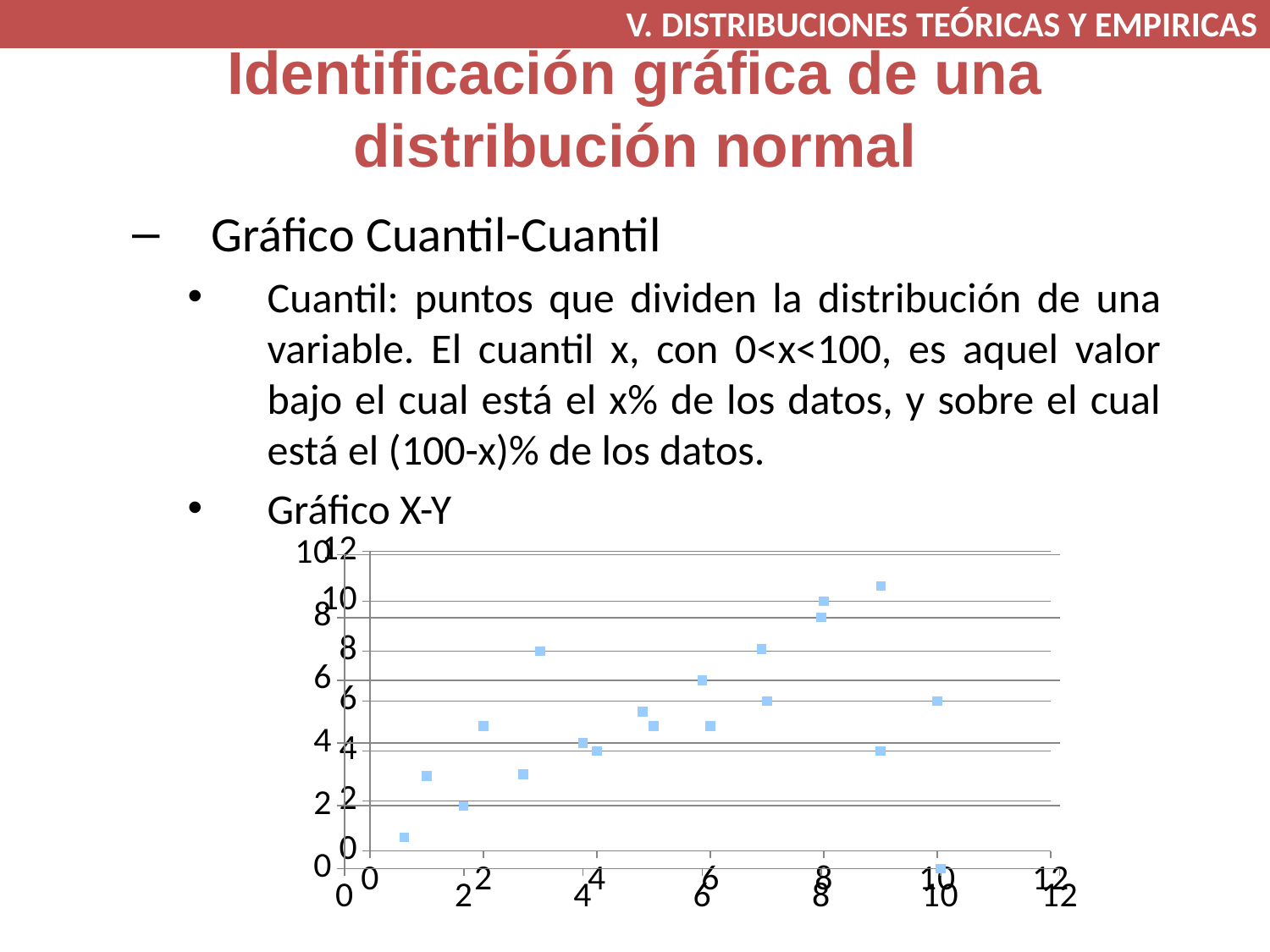
What kind of chart is shown on the slide? scatter chart Is the y value of the point with the smallest x value greater or less than 2? less Is the y value of the lowest point in the chart greater or less than 2? less What is the highest value shown on the y axis of the chart? 12 What is the highest value shown on the x axis of the chart? 12 Do the plotted points generally rise or fall as the x value increases? rise